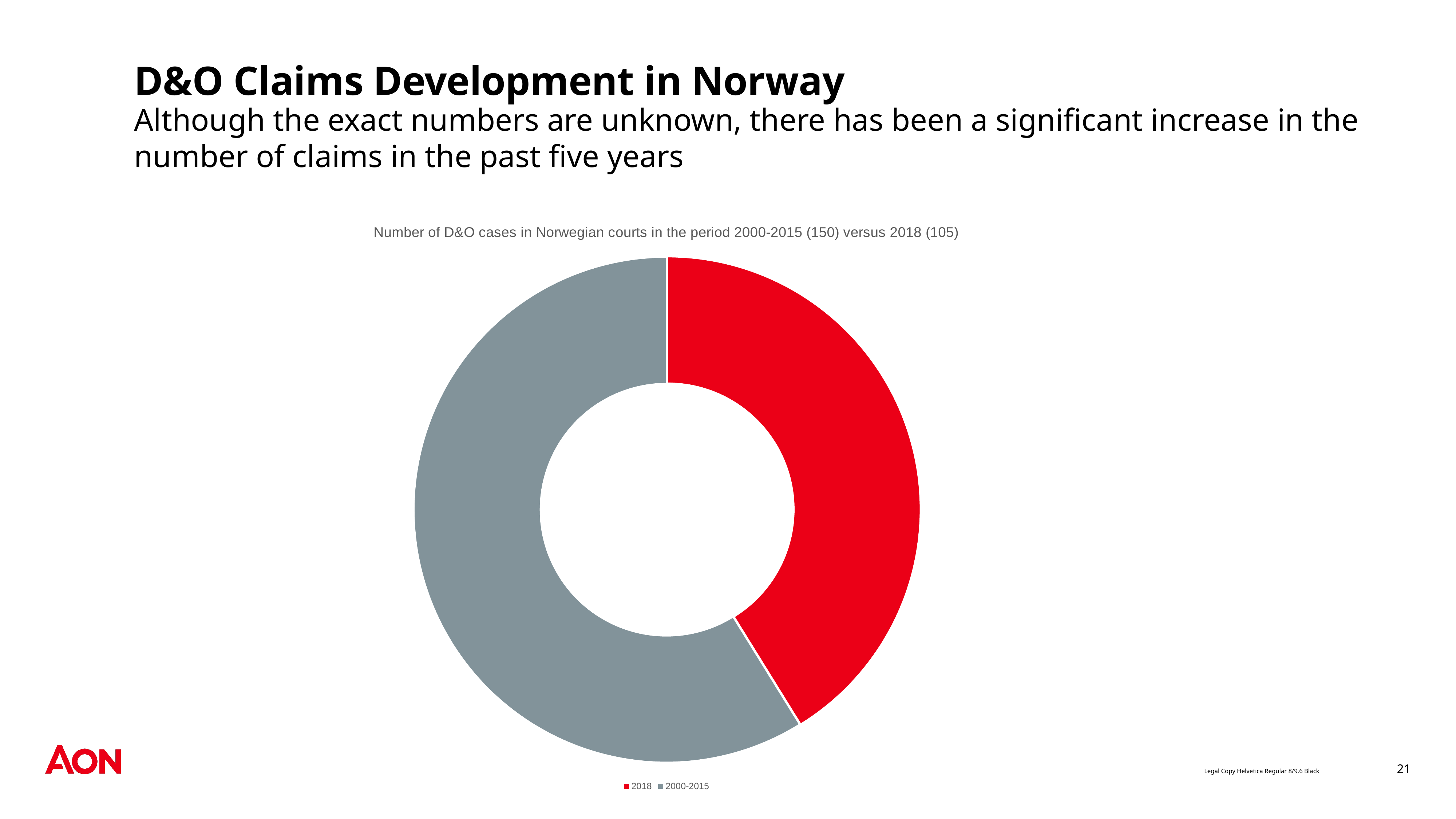
What type of chart is shown on the slide? Doughnut (pie) chart What is the difference between the number of cases in 2000-2015 and in 2018? 45 How many entries does the legend list? 2 What is the title of the chart? Number of D&O cases in Norwegian courts in the period 2000-2015 (150) versus 2018 (105) Which slice of the chart is the largest? 2000-2015 Which slice of the chart is the smallest? 2018 Which category has the larger number of D&O cases, 2018 or 2000-2015? 2000-2015 How many D&O cases in Norwegian courts are given for the period 2000-2015? 150 How many D&O cases in Norwegian courts are given for 2018? 105 What is the total number of D&O cases across both categories shown in the chart? 255 What colour represents 2018 in the chart? Red How many categories does the chart show? 2